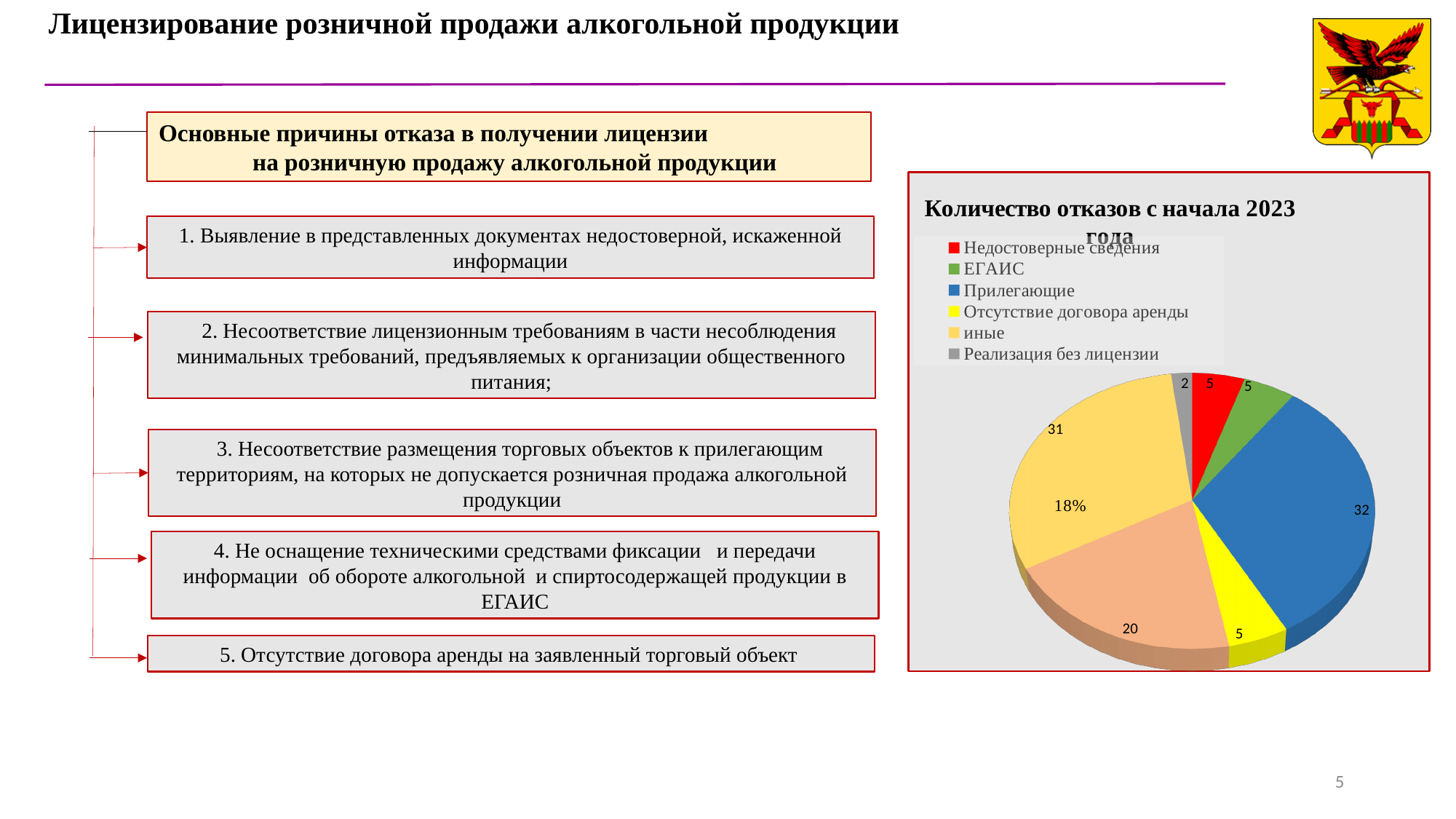
Which is larger in the pie chart: Прилегающие or Реализация без лицензии? Прилегающие What is the value for Прилегающие in the pie chart? 32 What is the value for Отсутствие договора аренды in the pie chart? 5 What is the value for Реализация без лицензии in the pie chart? 2 What is the difference between the values for Прилегающие and Реализация без лицензии? 30 What is the value for ЕГАИС in the pie chart? 5 How many entries does the legend of the pie chart list? 6 What is the value for Недостоверные сведения in the pie chart? 5 What colour represents Прилегающие in the pie chart? blue Which legend category has the smallest value in the pie chart? Реализация без лицензии What kind of chart is shown on the slide? pie chart What is the title of the pie chart? Количество отказов с начала 2023 года